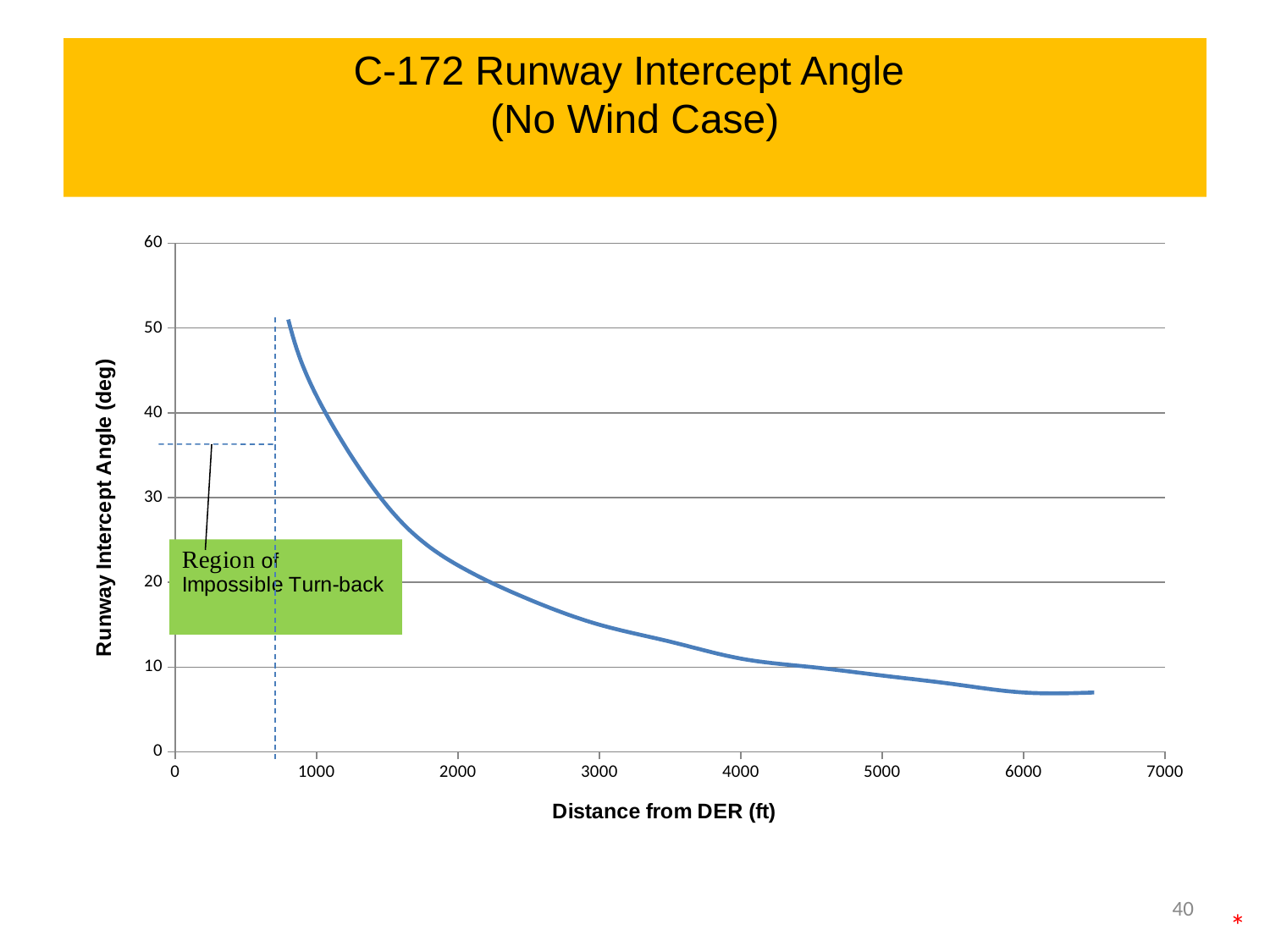
What is the label of the x axis? Distance from DER (ft) Is the runway intercept angle at 3000 ft greater or less than 20? less Is the runway intercept angle at 1200 ft greater or less than 40? less Is the runway intercept angle at 6000 ft greater or less than 10? less What kind of chart is shown on the slide? line chart How many lines are plotted on the chart? 1 What is the title of the chart? C-172 Runway Intercept Angle (No Wind Case) Does the runway intercept angle rise or fall as the distance from DER increases? fall